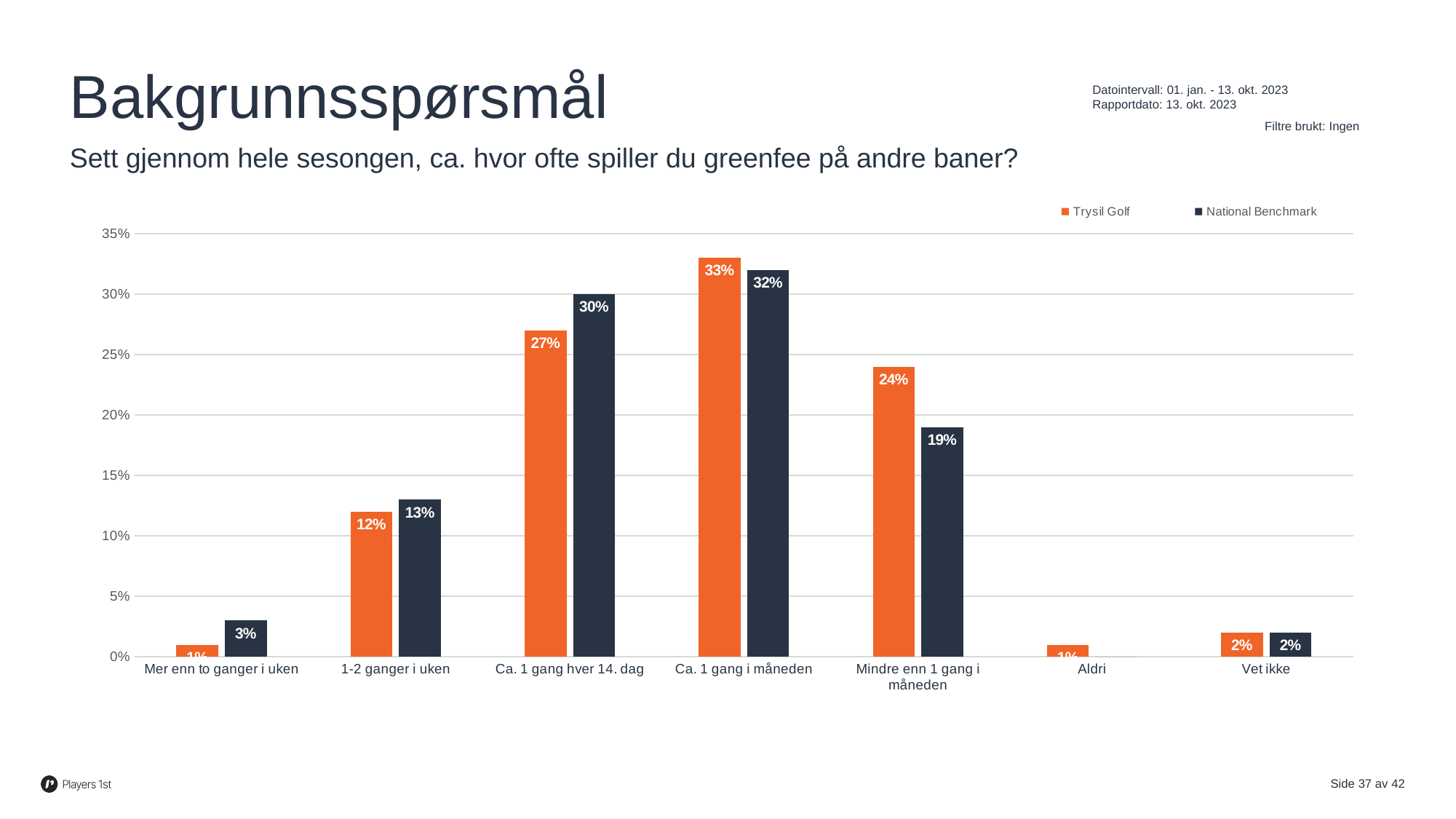
What is the National Benchmark value for "Mindre enn 1 gang i måneden"? 19% What is the difference between the Trysil Golf and National Benchmark values for "Mindre enn 1 gang i måneden"? 5% What kind of chart is shown on the slide? Bar chart Which category has the highest Trysil Golf value? Ca. 1 gang i måneden What is the Trysil Golf value for "Ca. 1 gang i måneden"? 33% Is the Trysil Golf value for "Ca. 1 gang hver 14. dag" greater or less than 25%? greater What is the Trysil Golf value for "1-2 ganger i uken"? 12% For "1-2 ganger i uken", which is larger: Trysil Golf or National Benchmark? National Benchmark What is the National Benchmark value for "Ca. 1 gang hver 14. dag"? 30% How many series does the legend list? 2 How many categories are shown on the x axis? 7 What is the difference between the National Benchmark and Trysil Golf values for "Ca. 1 gang hver 14. dag"? 3%